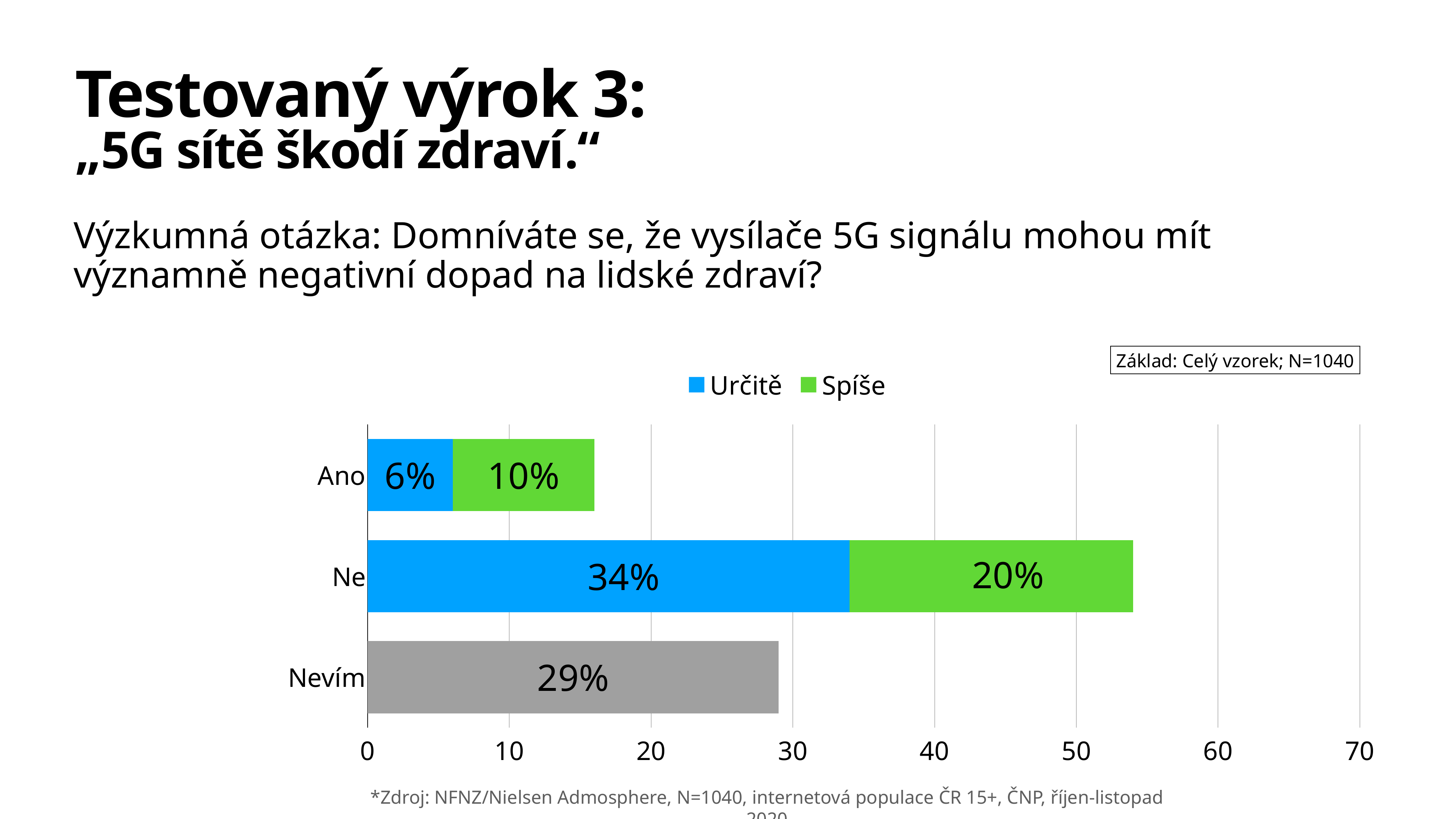
What is the value shown for the 'Nevím' category? 29% Which category has the longest bar overall? Ne What is the 'Spíše' value for the 'Ano' category? 10% How many categories are shown on the vertical axis? 3 What is the difference between the 'Určitě' values for 'Ne' and 'Ano'? 28% What is the total of the stacked bar for 'Ano'? 16% What is the 'Určitě' value for the 'Ne' category? 34% Which is larger: the 'Spíše' value for 'Ne' or the 'Spíše' value for 'Ano'? Ne What kind of chart is shown on the slide? Bar chart How many series does the legend list? 2 What is the total of the stacked bar for 'Ne'? 54% What is the 'Určitě' value for the 'Ano' category? 6%